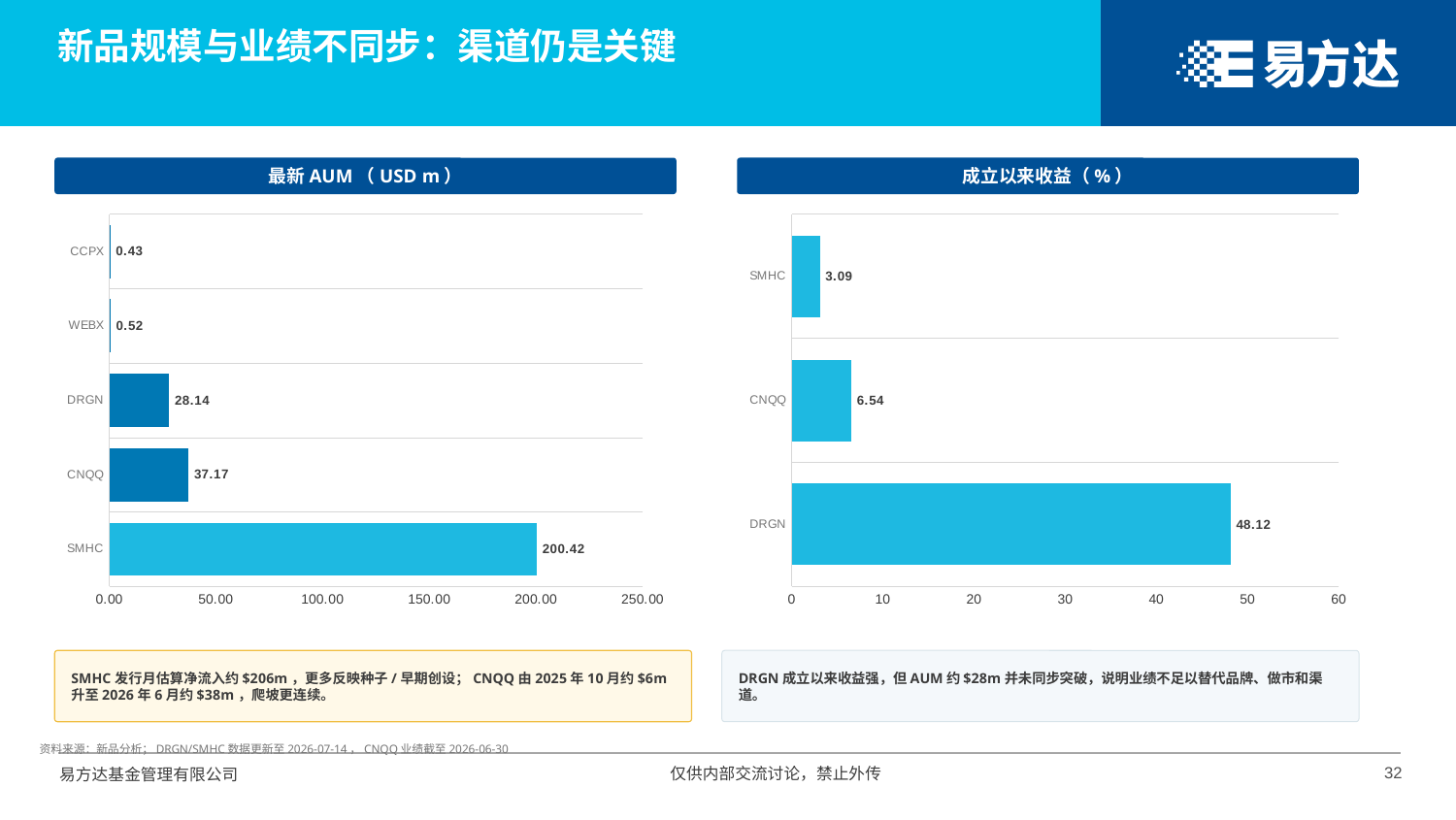
In the 最新 AUM（USD m）chart, what is the value for SMHC? 200.42 What type of chart is the 成立以来收益（%）chart? Bar chart In the 最新 AUM（USD m）chart, what is the value for DRGN? 28.14 In the 成立以来收益（%）chart, what is the value for DRGN? 48.12 In the 最新 AUM（USD m）chart, how many categories are shown? 5 In the 最新 AUM（USD m）chart, which category has the highest value? SMHC In the 成立以来收益（%）chart, which is larger, CNQQ or SMHC? CNQQ In the 成立以来收益（%）chart, what is the value for CNQQ? 6.54 In the 成立以来收益（%）chart, which category has the lowest value? SMHC In the 最新 AUM（USD m）chart, which category has the lowest value? CCPX In the 成立以来收益（%）chart, what is the difference between DRGN and SMHC? 45.03 In the 最新 AUM（USD m）chart, what is the difference between CNQQ and DRGN? 9.03